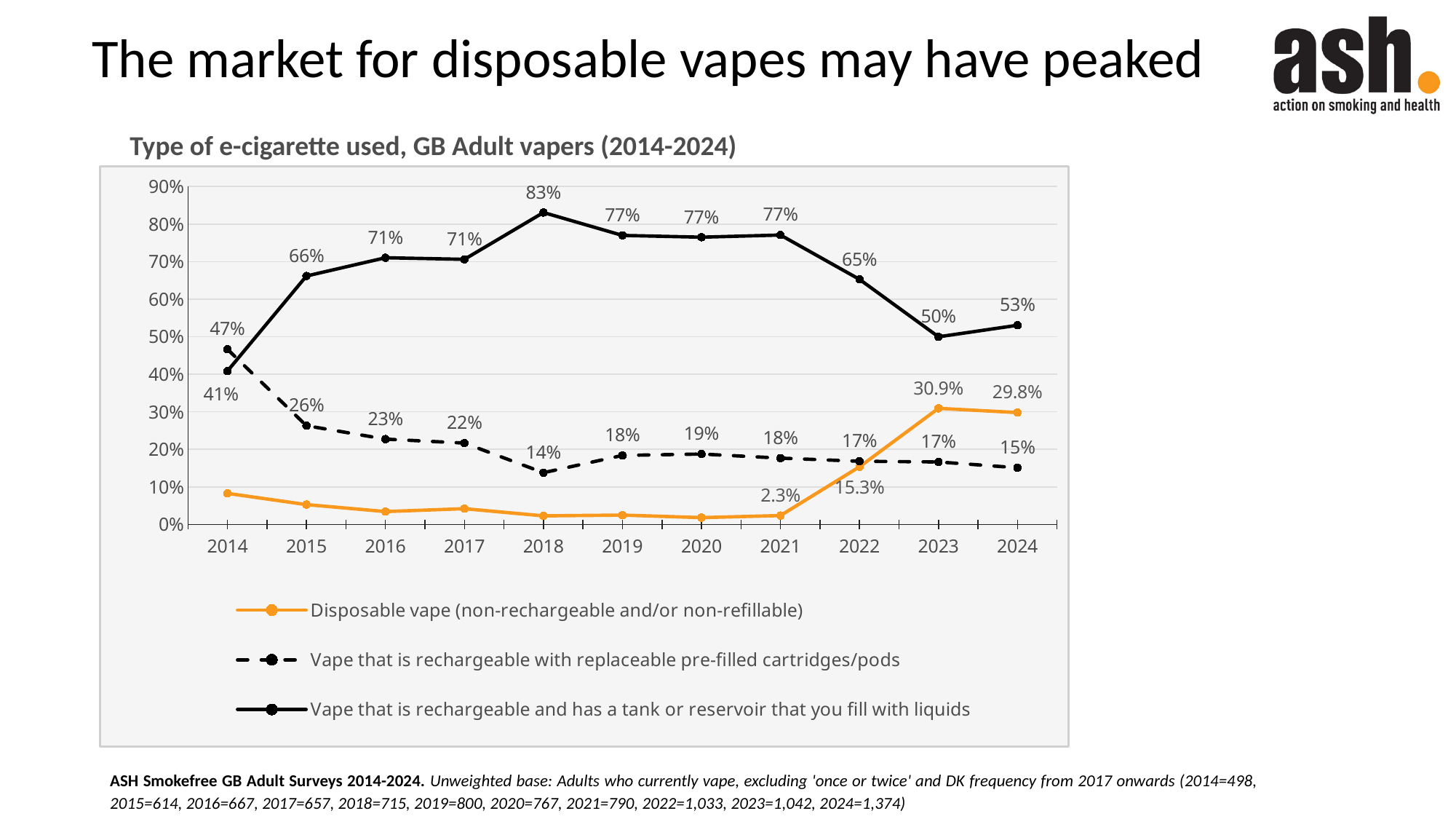
What was the value for vapes that are rechargeable with replaceable pre-filled cartridges/pods in 2024? 15% How many series does the legend list? 3 What was the value for disposable vapes in 2023? 30.9% In 2024, which was larger: the tank/reservoir vape value or the pre-filled cartridges/pods value? Tank/reservoir vape How many years are shown on the x axis? 11 What kind of chart is shown on the slide? Line chart By how many percentage points did the disposable vape value change from 2023 to 2024? 1.1 percentage points In which year was the disposable vape series at its highest? 2023 Is the value for disposable vapes in 2014 greater or less than 10%? less What was the value for disposable vapes in 2021? 2.3% What percentage of GB adult vapers used a vape that is rechargeable and has a tank or reservoir in 2018? 83% In which year did the tank/reservoir vape series reach its highest value? 2018